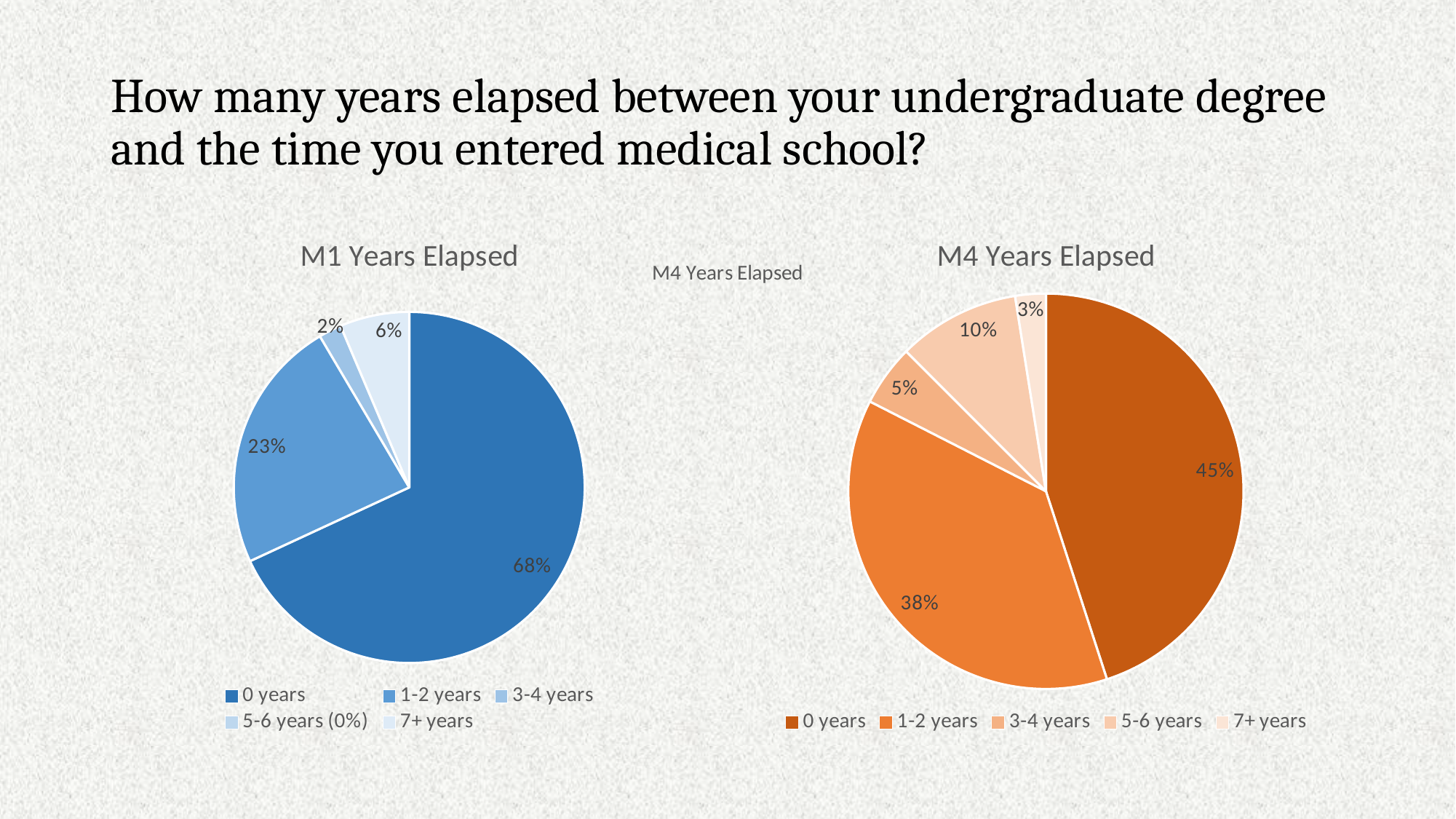
In the M1 Years Elapsed chart, what percentage is shown for 1-2 years? 23% In the M4 Years Elapsed chart, what percentage is shown for 5-6 years? 10% In the M1 Years Elapsed chart, what percentage is shown for 7+ years? 6% In the M1 Years Elapsed chart, what share of respondents reported 0 years? 68% Which is larger in the M1 Years Elapsed chart: the 1-2 years slice or the 7+ years slice? 1-2 years In the M4 Years Elapsed chart, what is the difference between the 0 years and 1-2 years shares? 7% In the M1 Years Elapsed chart, what percentage does the legend show for 5-6 years? 0% In the M4 Years Elapsed chart, which category has the largest slice? 0 years In the M4 Years Elapsed chart, which category has the smallest slice? 7+ years In the M4 Years Elapsed chart, what share of respondents reported 0 years? 45% How many categories does the legend of the M4 Years Elapsed chart list? 5 What type of chart is the M1 Years Elapsed chart? Pie chart